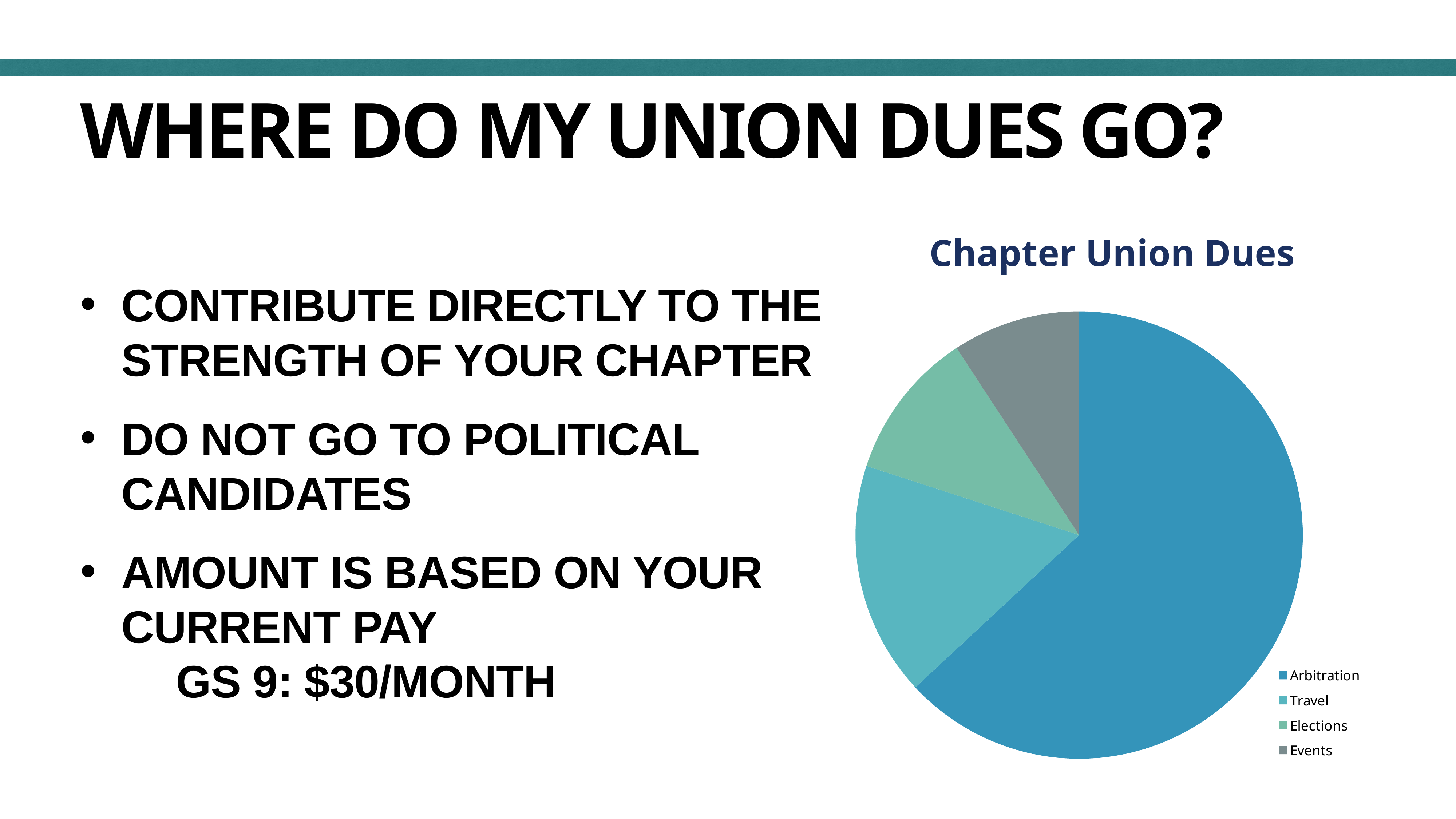
Which category takes the largest share of the Chapter Union Dues pie chart? Arbitration Does Arbitration account for more or less than half of the Chapter Union Dues pie? More Which is larger in the Chapter Union Dues chart, Travel or Events? Travel What is the title of the chart? Chapter Union Dues Which is larger in the Chapter Union Dues chart, Arbitration or Elections? Arbitration How many entries does the legend of the Chapter Union Dues chart list? 4 How many slices does the Chapter Union Dues pie chart have? 4 What kind of chart is shown on the slide? Pie chart Which category is listed last in the legend of the Chapter Union Dues chart? Events